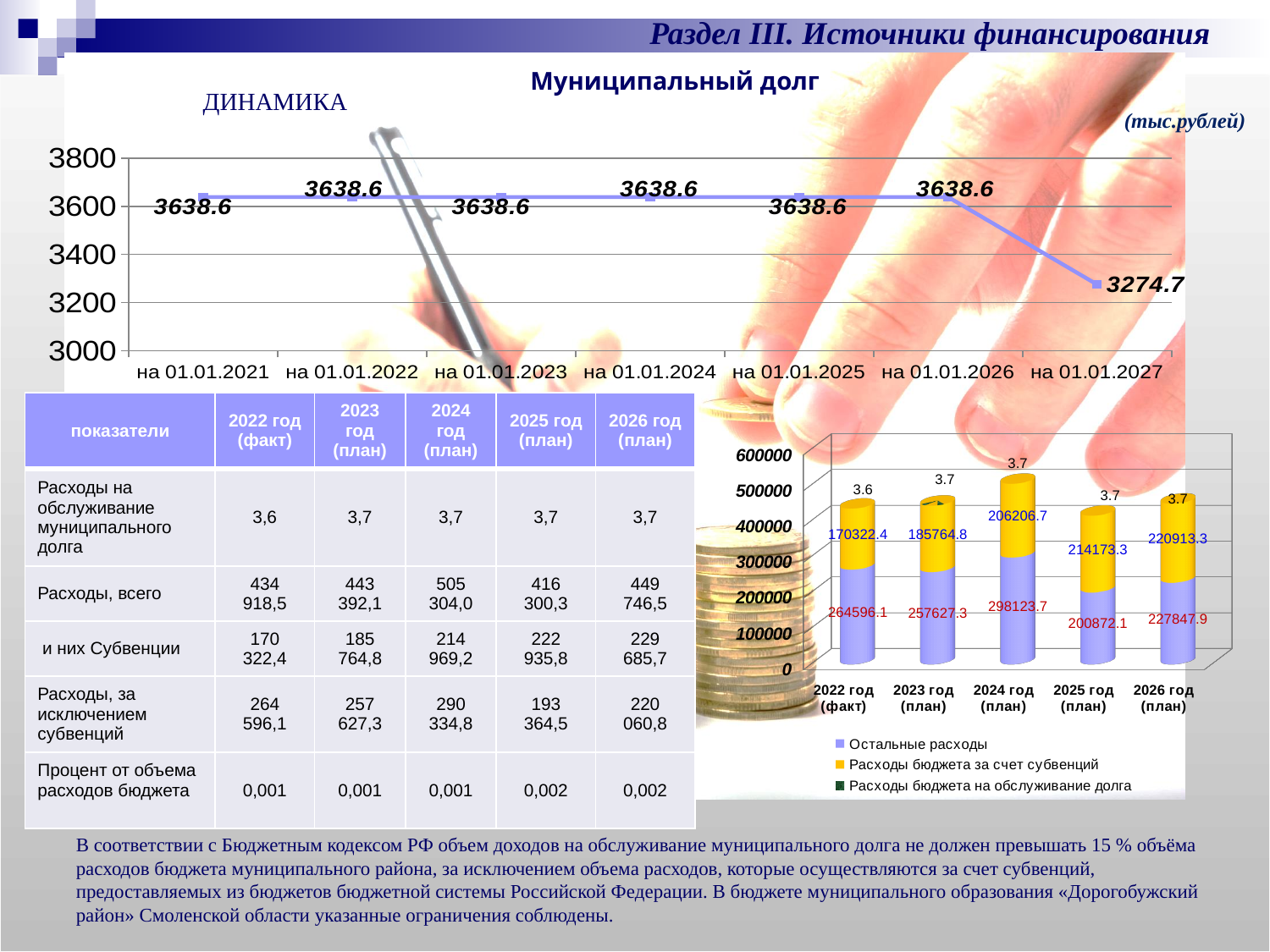
In the line chart 'Муниципальный долг', what is the difference between the value for на 01.01.2026 and the value for на 01.01.2027? 363.9 In the stacked bar chart at the bottom right, how many series does the legend list? 3 In the line chart 'Муниципальный долг', what is the value for на 01.01.2027? 3274.7 In the stacked bar chart at the bottom right, what is the value of 'Расходы бюджета за счет субвенций' for 2026 год (план)? 220913.3 What kind of chart is the chart at the bottom right of the slide? stacked bar chart In the stacked bar chart at the bottom right, what is the value of 'Остальные расходы' for 2024 год (план)? 298123.7 In the line chart 'Муниципальный долг', how many data points are plotted? 7 In the line chart 'Муниципальный долг', which date has the lowest value? на 01.01.2027 In the stacked bar chart at the bottom right, which year has the highest value of 'Остальные расходы'? 2024 год (план) In the stacked bar chart at the bottom right, is the value of 'Остальные расходы' for 2022 год (факт) larger or smaller than for 2025 год (план)? larger In the line chart 'Муниципальный долг', does the value rise, fall or stay flat between на 01.01.2026 and на 01.01.2027? fall In the line chart 'Муниципальный долг', what is the value for на 01.01.2021? 3638.6